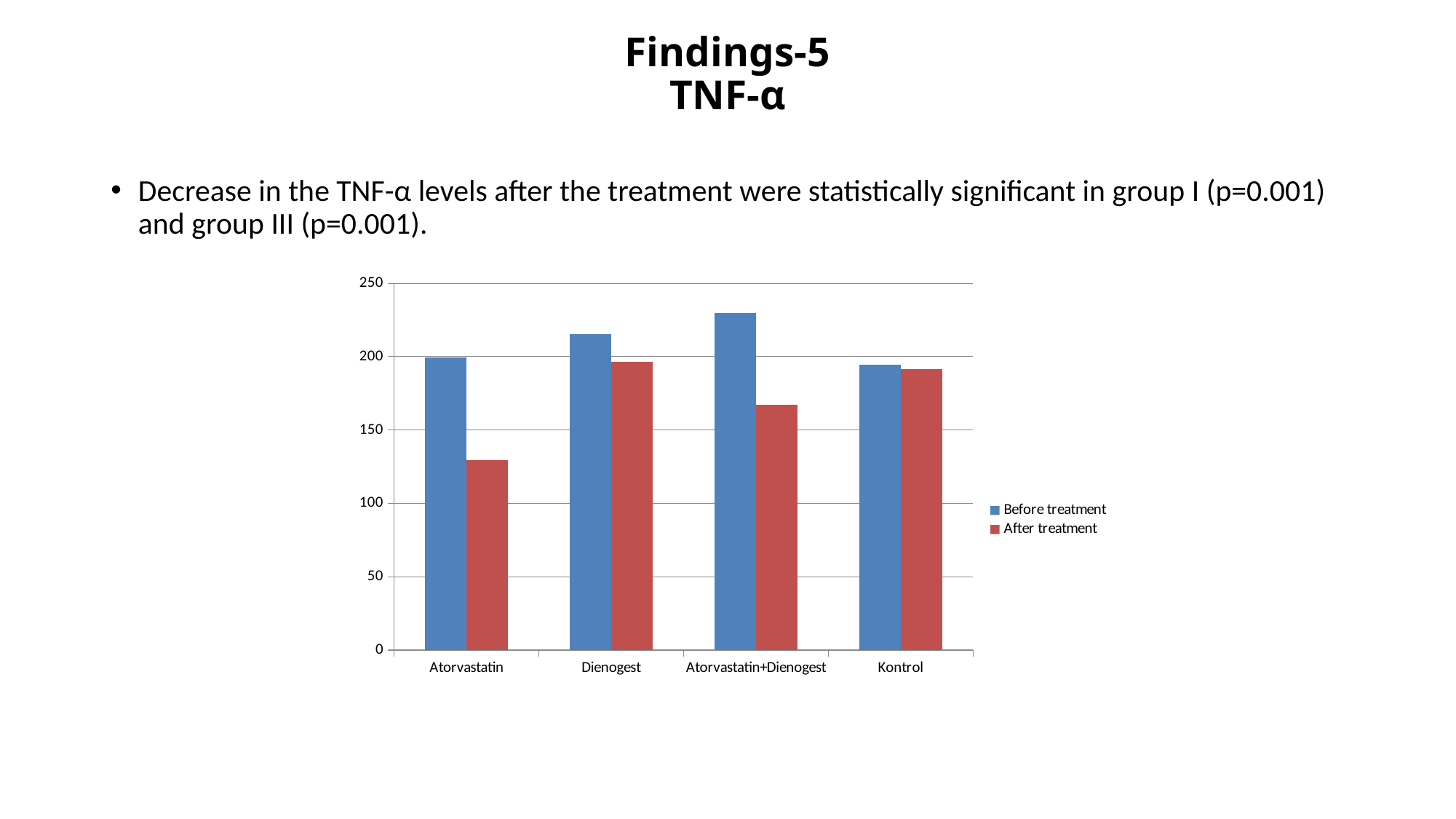
Is the After treatment value for Atorvastatin+Dienogest greater or less than 150? greater Is the After treatment value for Atorvastatin greater or less than 150? less How many categories are shown on the x axis of the chart? 4 How many series does the chart's legend list? 2 For Atorvastatin+Dienogest, which is larger: the Before treatment value or the After treatment value? Before treatment For Atorvastatin, which is larger: the Before treatment value or the After treatment value? Before treatment Which category has the highest Before treatment value? Atorvastatin+Dienogest Which category has the lowest After treatment value? Atorvastatin Is the Before treatment value for Dienogest greater or less than 200? greater What kind of chart is shown on the slide? bar chart What colour are the After treatment bars in the chart? red